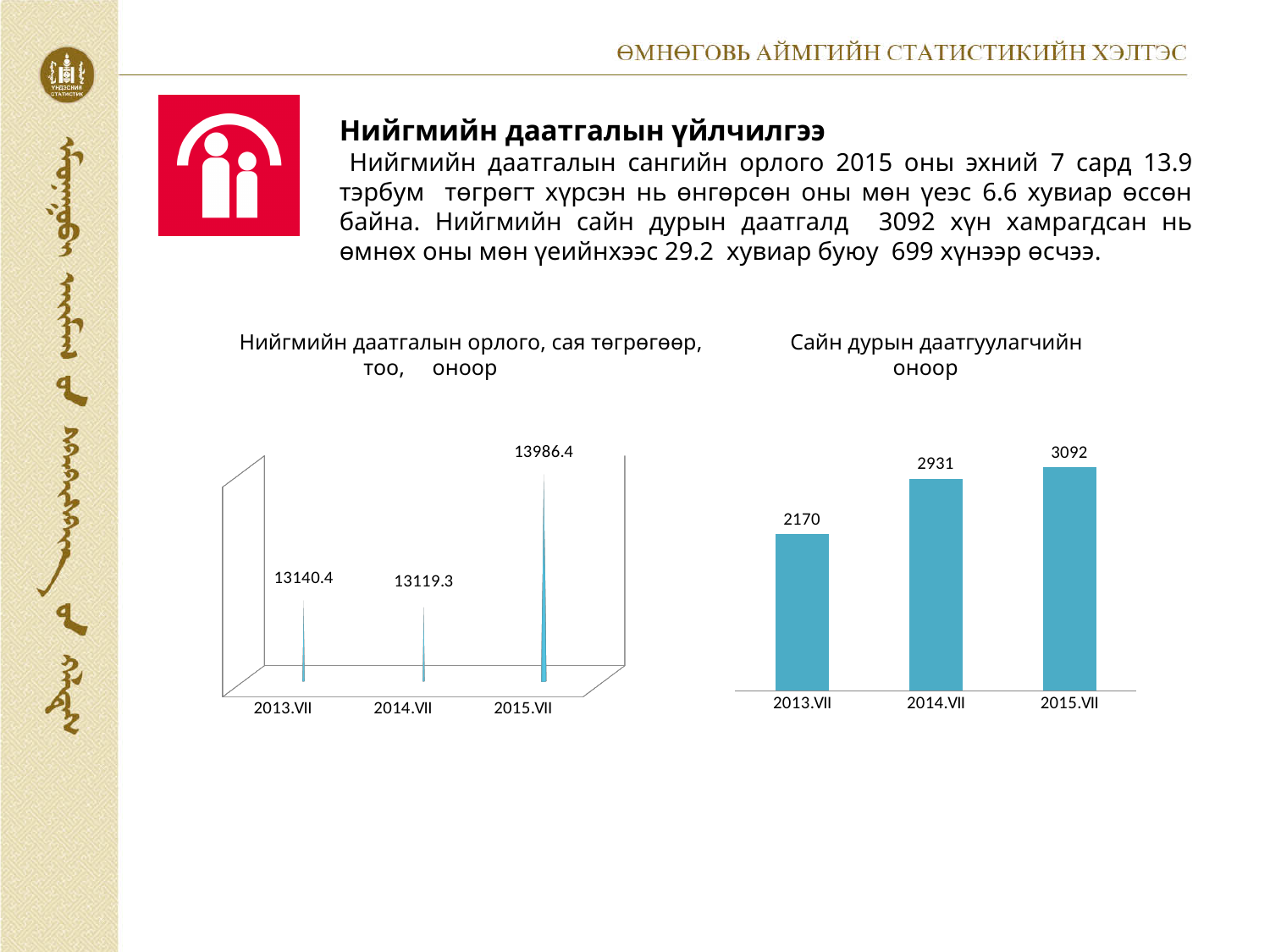
In the left chart (Нийгмийн даатгалын орлого), what is the difference between the values for 2015.VII and 2013.VII? 846 In the right chart (Сайн дурын даатгуулагчийн оноор), do the values rise or fall from 2013.VII to 2015.VII? rise In the right chart (Сайн дурын даатгуулагчийн оноор), which period has the highest value? 2015.VII In the right chart (Сайн дурын даатгуулагчийн оноор), what is the difference between the values for 2015.VII and 2014.VII? 161 What kind of chart is the right chart (Сайн дурын даатгуулагчийн оноор)? bar chart In the right chart (Сайн дурын даатгуулагчийн оноор), what is the value for 2013.VII? 2170 In the left chart (Нийгмийн даатгалын орлого), which period has the highest value? 2015.VII In the left chart (Нийгмийн даатгалын орлого), what is the value for 2015.VII? 13986.4 In the left chart (Нийгмийн даатгалын орлого), which period has the lowest value? 2014.VII How many periods are shown on the x axis of the right chart (Сайн дурын даатгуулагчийн оноор)? 3 In the right chart (Сайн дурын даатгуулагчийн оноор), what is the value for 2014.VII? 2931 In the left chart (Нийгмийн даатгалын орлого), what is the value for 2013.VII? 13140.4